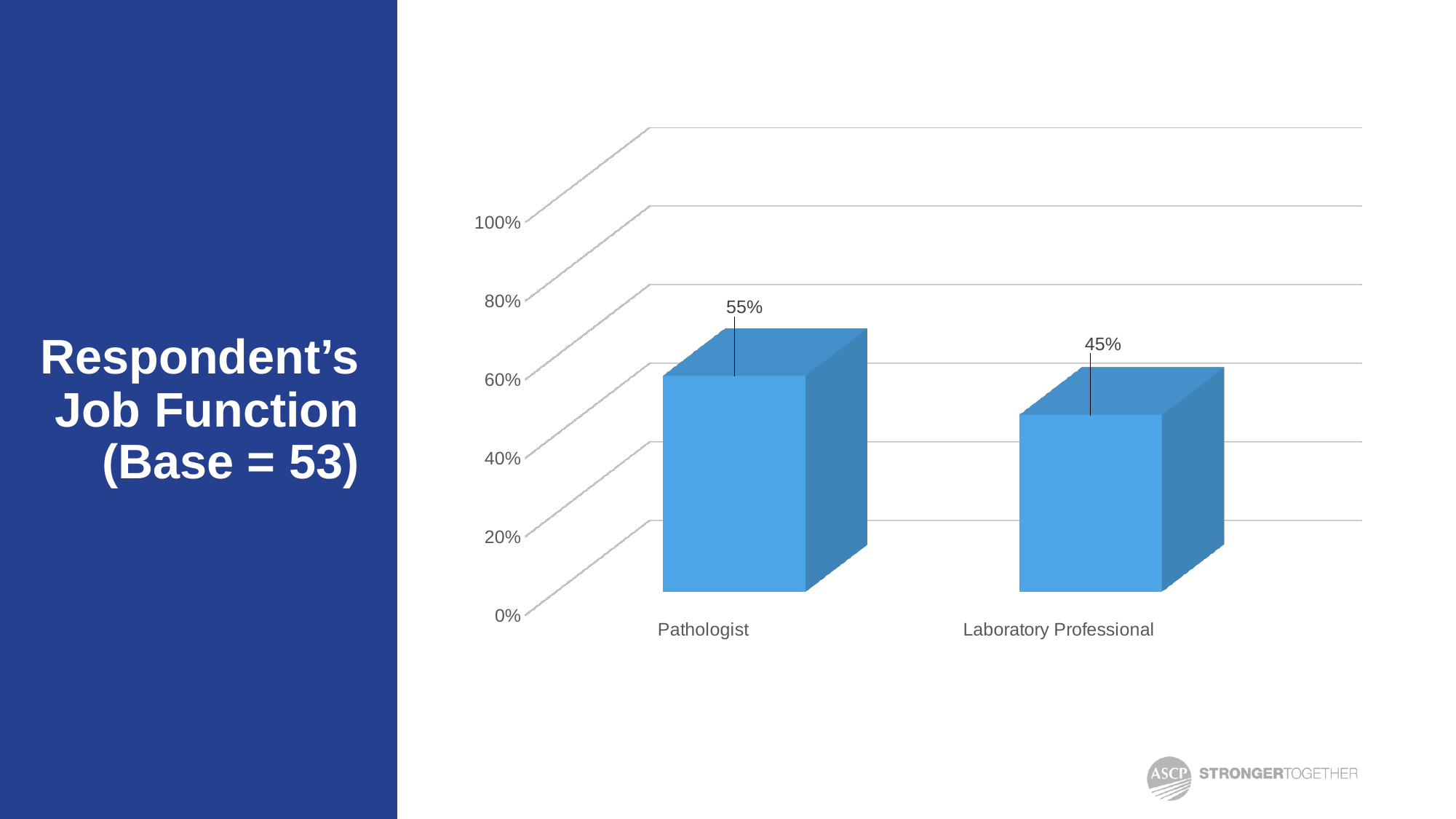
What is the base (number of respondents) stated in the slide title? 53 Which is larger, the value for Pathologist or for Laboratory Professional? Pathologist Is the value for Pathologist greater or less than 40%? greater What kind of chart is shown on the slide? Bar chart What is the total of the two percentages shown in the chart? 100% What percentage of respondents are Laboratory Professionals? 45% Which job function has the highest share of respondents? Pathologist What percentage of respondents are Pathologists? 55% What is the difference between the Pathologist and Laboratory Professional percentages? 10% How many job function categories are shown in the chart? 2 Which job function has the lowest share of respondents? Laboratory Professional Is the value for Laboratory Professional greater or less than 60%? less